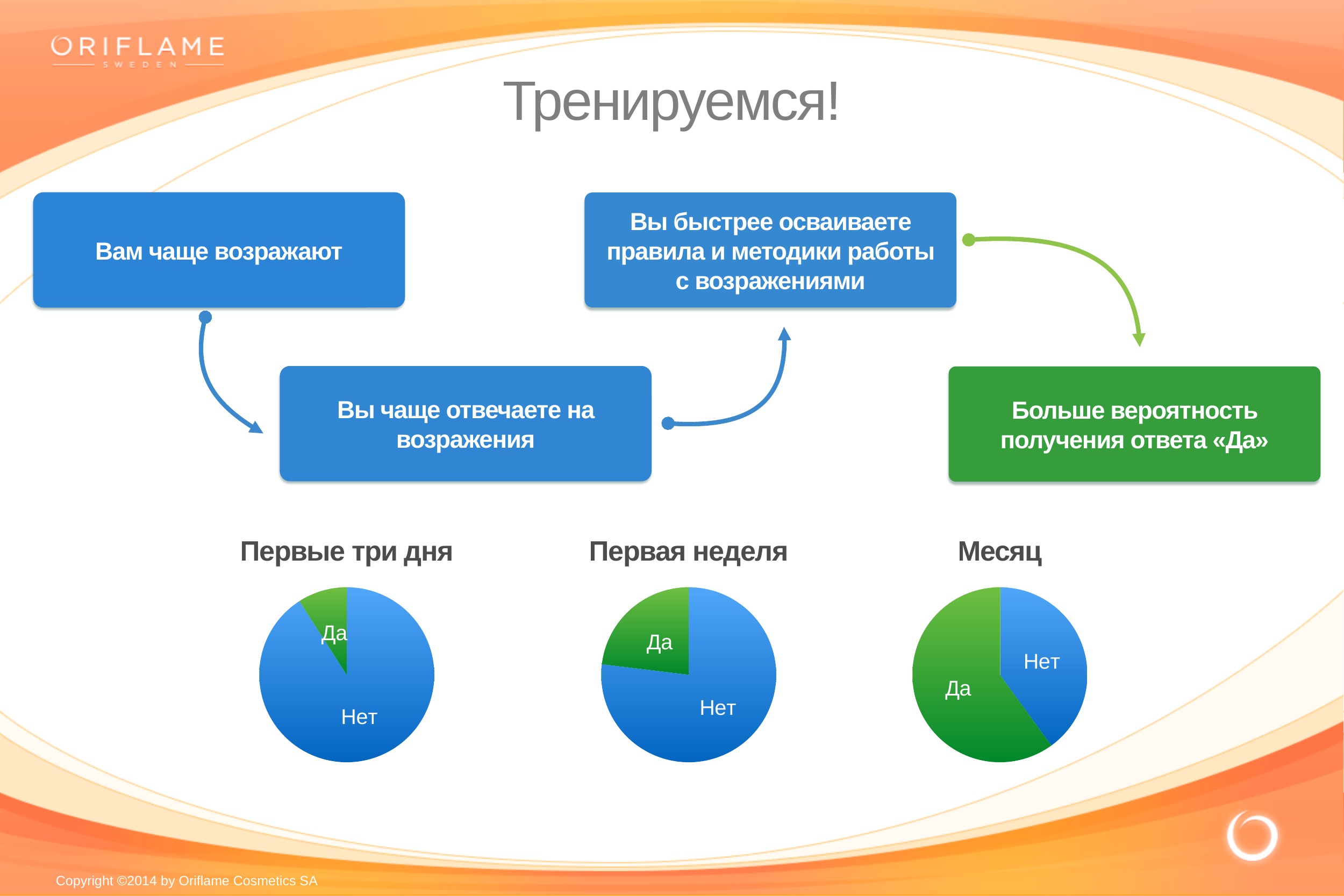
What colour is the "Да" slice in the "Месяц" pie chart? Green Across the three pie charts from "Первые три дня" to "Месяц", does the share of "Да" increase or decrease? Increase What kind of chart is the "Первые три дня" chart? Pie chart What is the title of the pie chart on the right of the slide? Месяц How many slices does the "Первая неделя" pie chart have? 2 In the "Первая неделя" pie chart, is the "Да" slice greater or less than half of the pie? less In the "Месяц" pie chart, which slice is the smallest? Нет In the "Первые три дня" pie chart, which slice is larger, "Да" or "Нет"? Нет In the "Первая неделя" pie chart, which slice is the largest? Нет How many pie charts are shown on the slide? 3 In the "Первые три дня" pie chart, which slice is the smallest? Да In the "Месяц" pie chart, which slice is larger, "Да" or "Нет"? Да